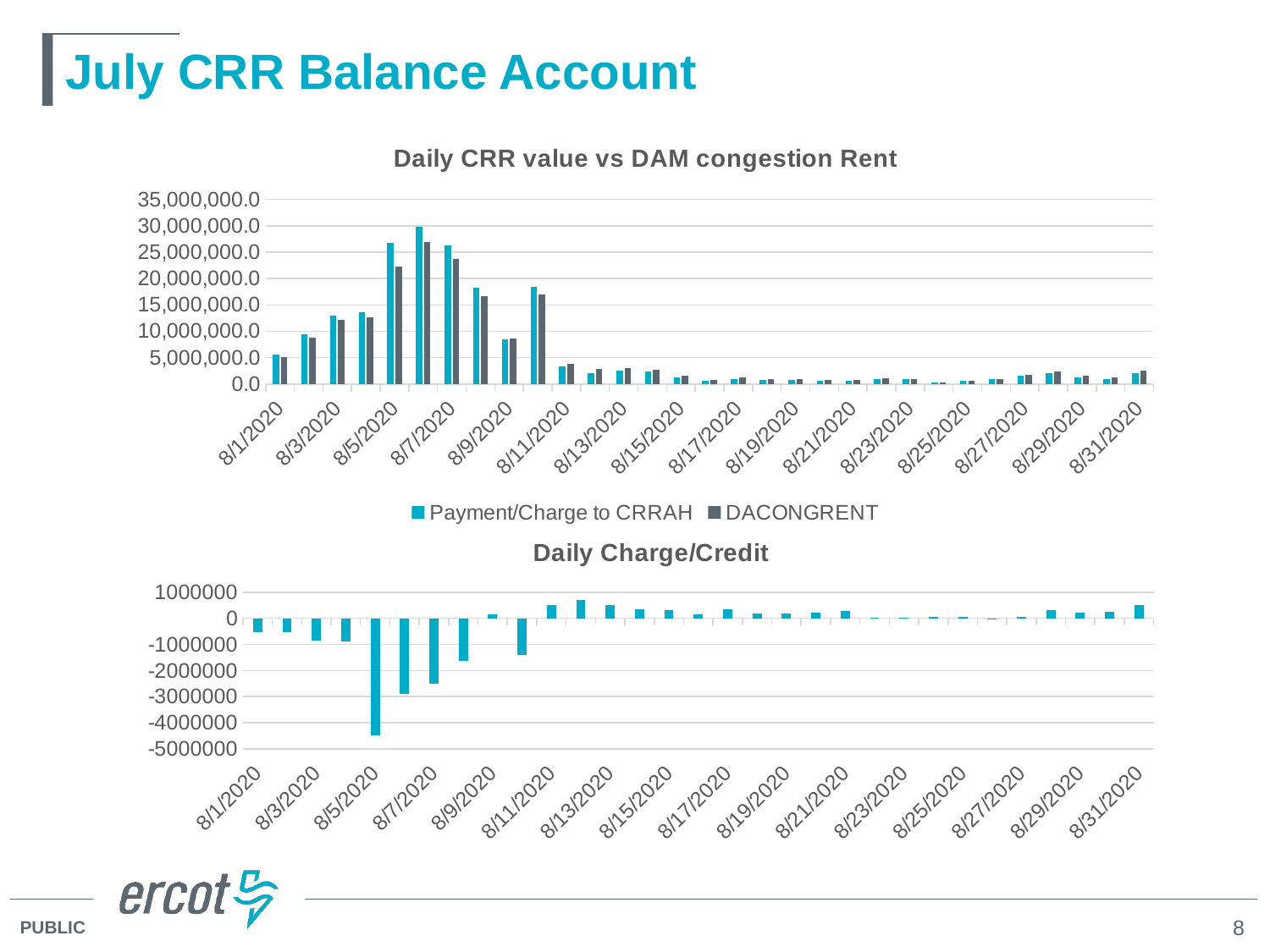
In the bottom chart "Daily Charge/Credit", which date has the lowest value? 8/5/2020 In the top chart "Daily CRR value vs DAM congestion Rent", is the DACONGRENT value for 8/5/2020 greater or less than 20,000,000.0? greater In the top chart "Daily CRR value vs DAM congestion Rent", is the Payment/Charge to CRRAH value for 8/7/2020 greater or less than 25,000,000.0? greater In the top chart "Daily CRR value vs DAM congestion Rent", is the Payment/Charge to CRRAH value for 8/1/2020 greater or less than 10,000,000.0? less What type of chart is the top chart titled "Daily CRR value vs DAM congestion Rent"? Bar chart How many dates are labeled on the x axis of the top chart "Daily CRR value vs DAM congestion Rent"? 16 How many series does the legend of the top chart "Daily CRR value vs DAM congestion Rent" list? 2 In the top chart "Daily CRR value vs DAM congestion Rent", which is larger on 8/5/2020: Payment/Charge to CRRAH or DACONGRENT? Payment/Charge to CRRAH In the top chart "Daily CRR value vs DAM congestion Rent", what are the two series named in the legend? Payment/Charge to CRRAH and DACONGRENT In the top chart "Daily CRR value vs DAM congestion Rent", does the Payment/Charge to CRRAH series rise or fall from 8/7/2020 to 8/9/2020? fall What is the title of the bottom chart on the slide? Daily Charge/Credit